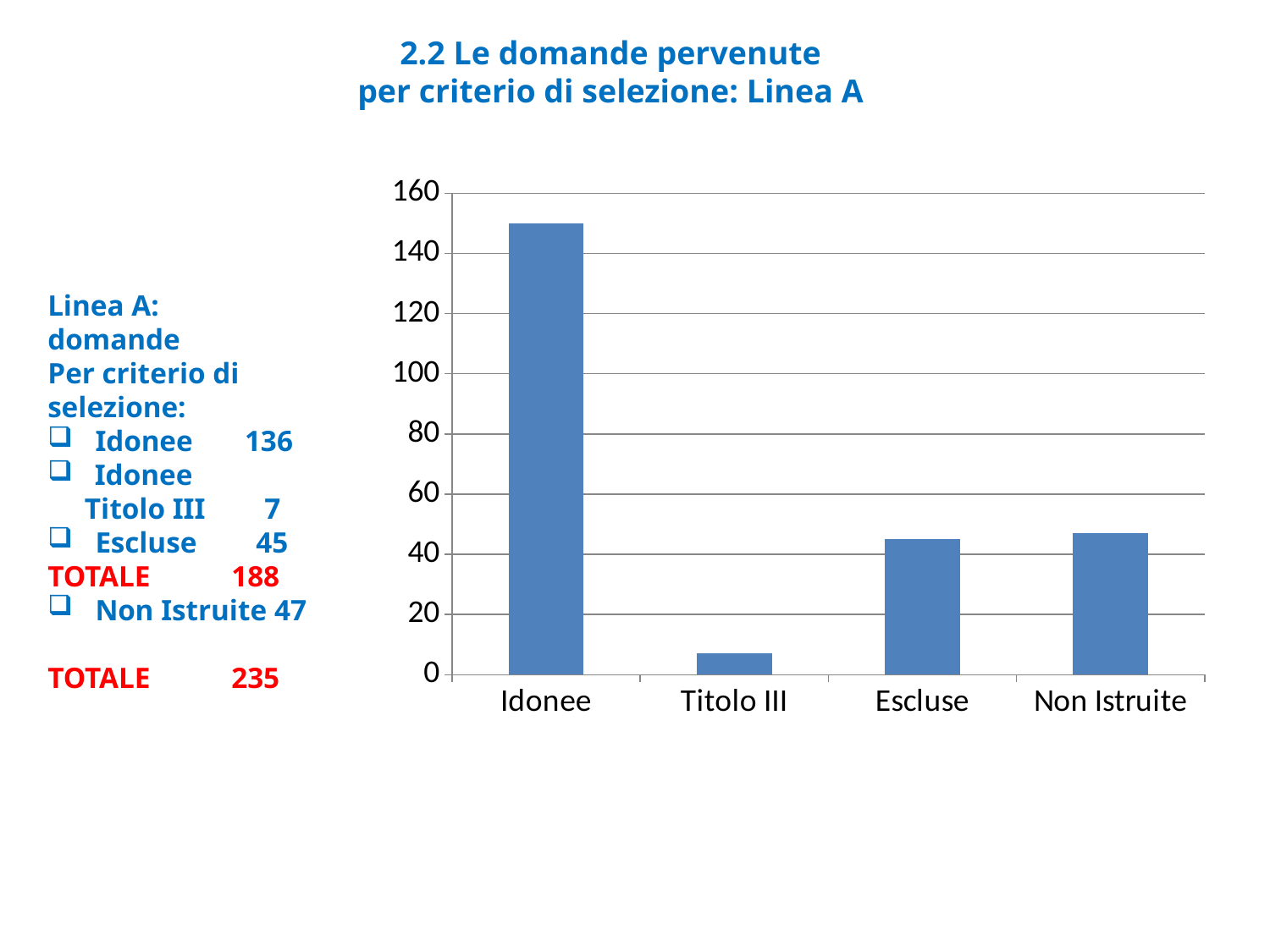
Which category has the lowest bar in the chart? Titolo III Is the value for Escluse greater or less than 40? greater Which is larger, the bar for Titolo III or the bar for Non Istruite? Non Istruite Which category has the highest bar in the chart? Idonee Which is larger, the bar for Idonee or the bar for Escluse? Idonee Is the value for Idonee greater or less than 140? greater What is the highest tick value shown on the y axis of the chart? 160 How many categories are shown on the x axis of the chart? 4 Is the value for Titolo III greater or less than 20? less What is the title of the slide containing the chart? 2.2 Le domande pervenute per criterio di selezione: Linea A What kind of chart is shown on the slide? bar chart